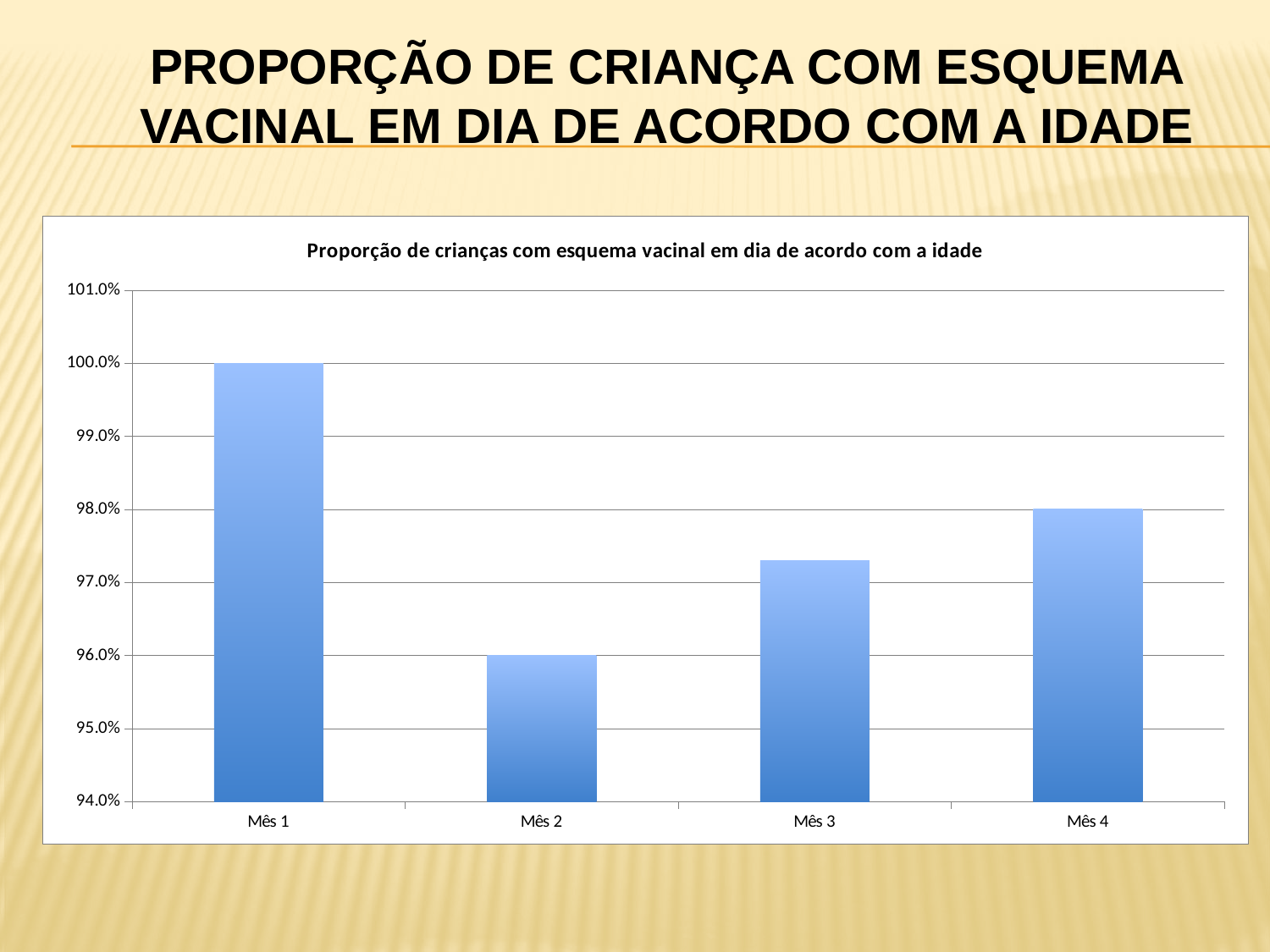
What is the difference between the values for Mês 4 and Mês 2? 2.0% Is the value for Mês 3 greater or less than 98.0%? less Which month has the lowest proportion? Mês 2 What is the value for Mês 4? 98.0% What is the value for Mês 2? 96.0% What is the value for Mês 1? 100.0% How many months are shown on the x axis? 4 Which is larger, the value for Mês 3 or the value for Mês 4? Mês 4 What kind of chart is shown on the slide? bar chart Is the value for Mês 3 greater or less than 97.0%? greater What is the difference between the values for Mês 1 and Mês 2? 4.0% Which month has the highest proportion? Mês 1